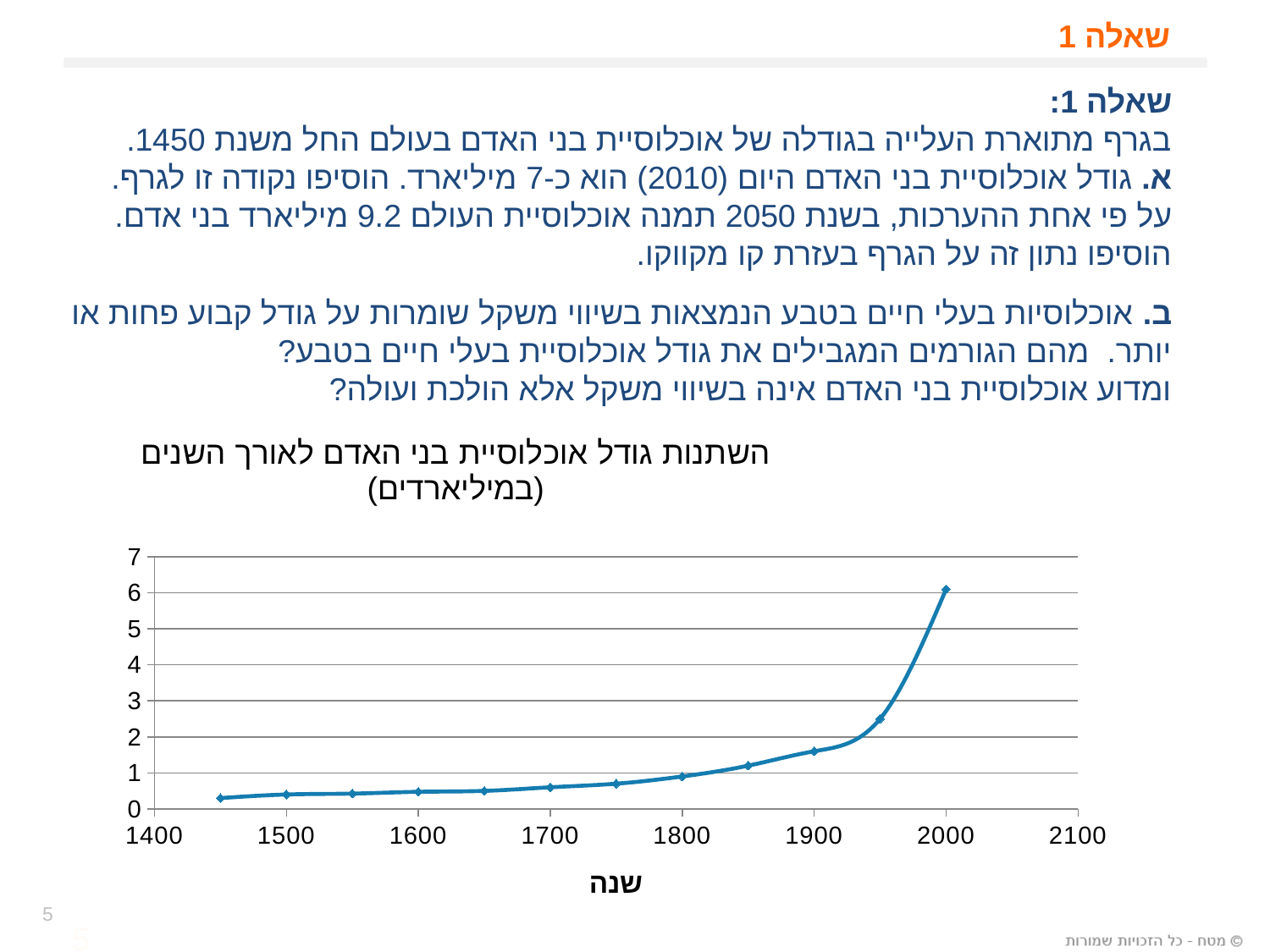
Which year has the highest plotted value? 2000 Is the value for the year 2000 greater or less than 5? greater Which year has the larger plotted value, 1900 or 1950? 1950 Do the plotted values rise or fall as the year increases along the x axis? rise Which year has the lowest plotted value? 1450 What kind of chart is shown on the slide? line chart What is the title of the x axis? שנה Is the value for the year 1900 greater or less than 2? less How many data points are plotted on the line? 12 Is the value for the year 1950 greater or less than 2? greater What is the highest tick value shown on the y axis? 7